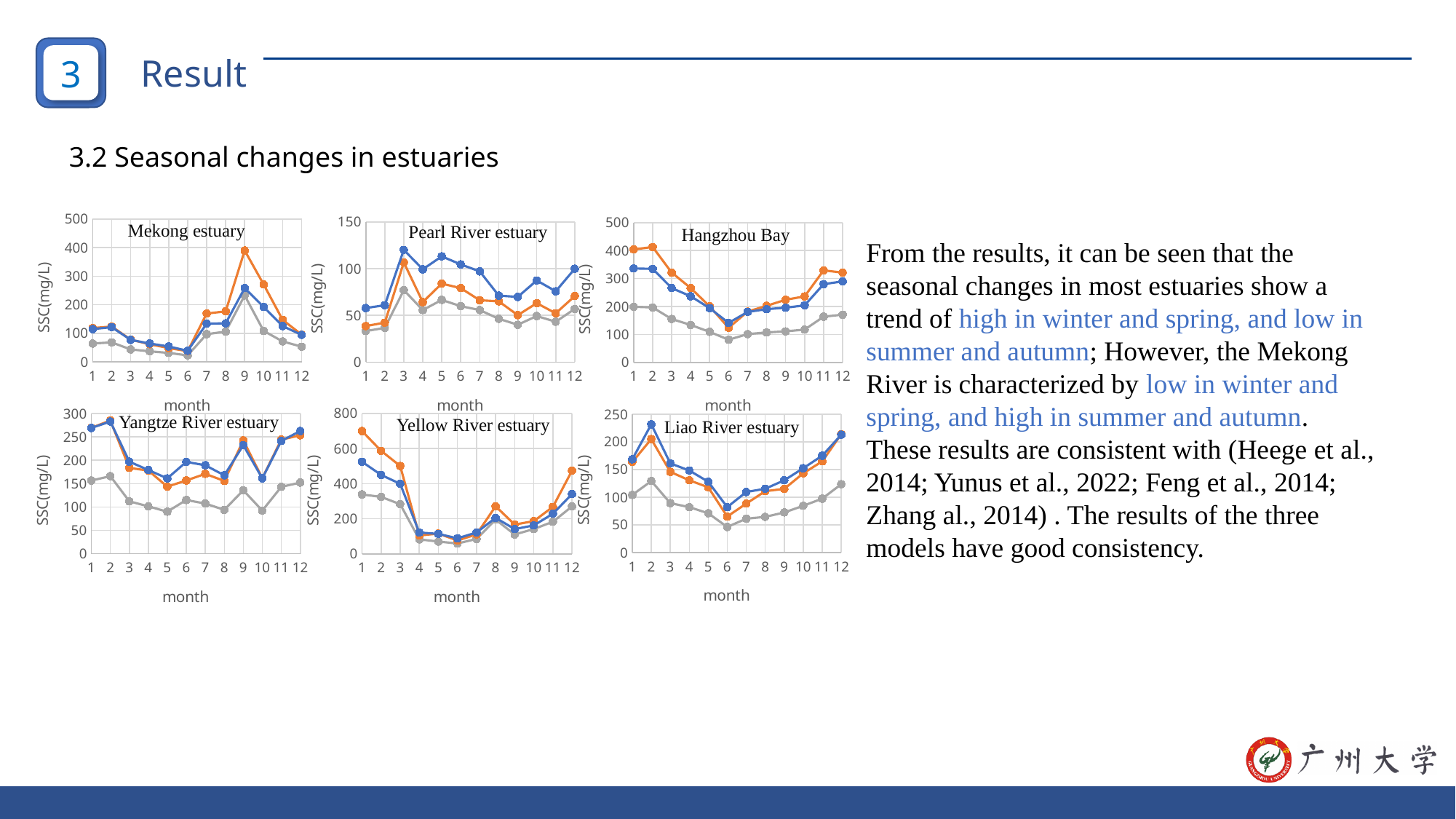
In the Hangzhou Bay chart, is the value of the orange series at month 2 greater or less than 300? greater In the Mekong estuary chart, is the value of the orange series at month 9 greater or less than 300? greater What kind of chart is the Mekong estuary chart? line chart In the Mekong estuary chart, in which month does the orange series reach its highest value? 9 In the Yangtze River estuary chart, is the value of the blue series at month 2 greater or less than 250? greater What is the y-axis label on the Yellow River estuary chart? SSC(mg/L) In the Hangzhou Bay chart, in which month does the blue series reach its lowest value? 6 In the Yellow River estuary chart, do the values of the orange series rise or fall from month 1 to month 6? fall How many months (data points) are plotted along the x axis of the Liao River estuary chart? 12 In the Liao River estuary chart, in which month does the blue series reach its highest value? 2 In the Pearl River estuary chart, in which month does the blue series reach its highest value? 3